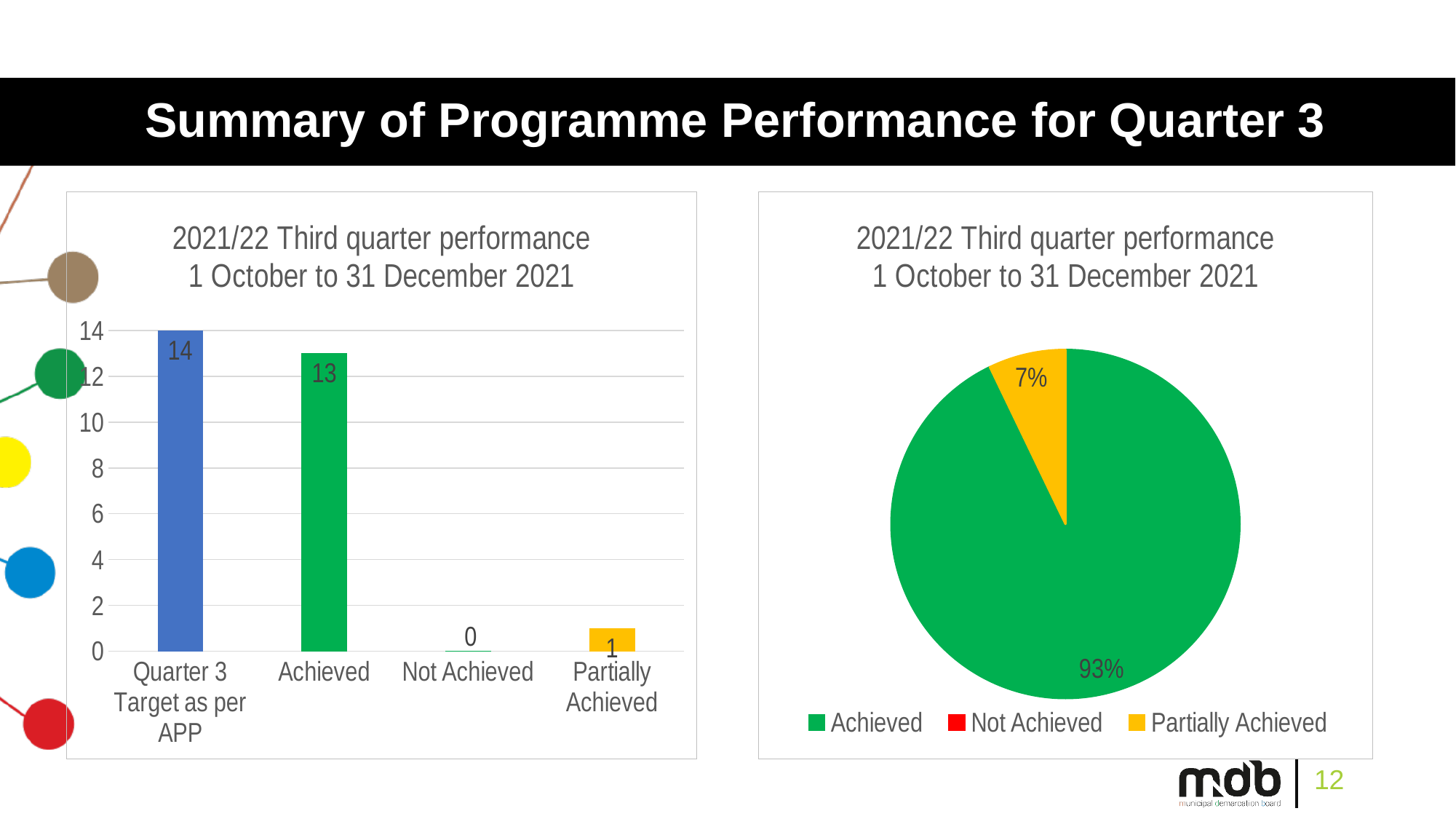
How many entries does the legend of the pie chart on the right list? 3 In the bar chart on the left, what is the value for Achieved? 13 In the pie chart on the right, what share is Partially Achieved? 7% In the bar chart on the left, what is the difference between the Quarter 3 Target as per APP and Achieved? 1 In the bar chart on the left, what is the value for Quarter 3 Target as per APP? 14 How many categories are shown in the bar chart on the left? 4 In the bar chart on the left, which is larger: Achieved or Partially Achieved? Achieved In the bar chart on the left, which category has the highest value? Quarter 3 Target as per APP What type of chart is the chart on the left? Bar chart In the bar chart on the left, what is the value for Partially Achieved? 1 In the pie chart on the right, what share is Achieved? 93% In the bar chart on the left, which category has the lowest value? Not Achieved